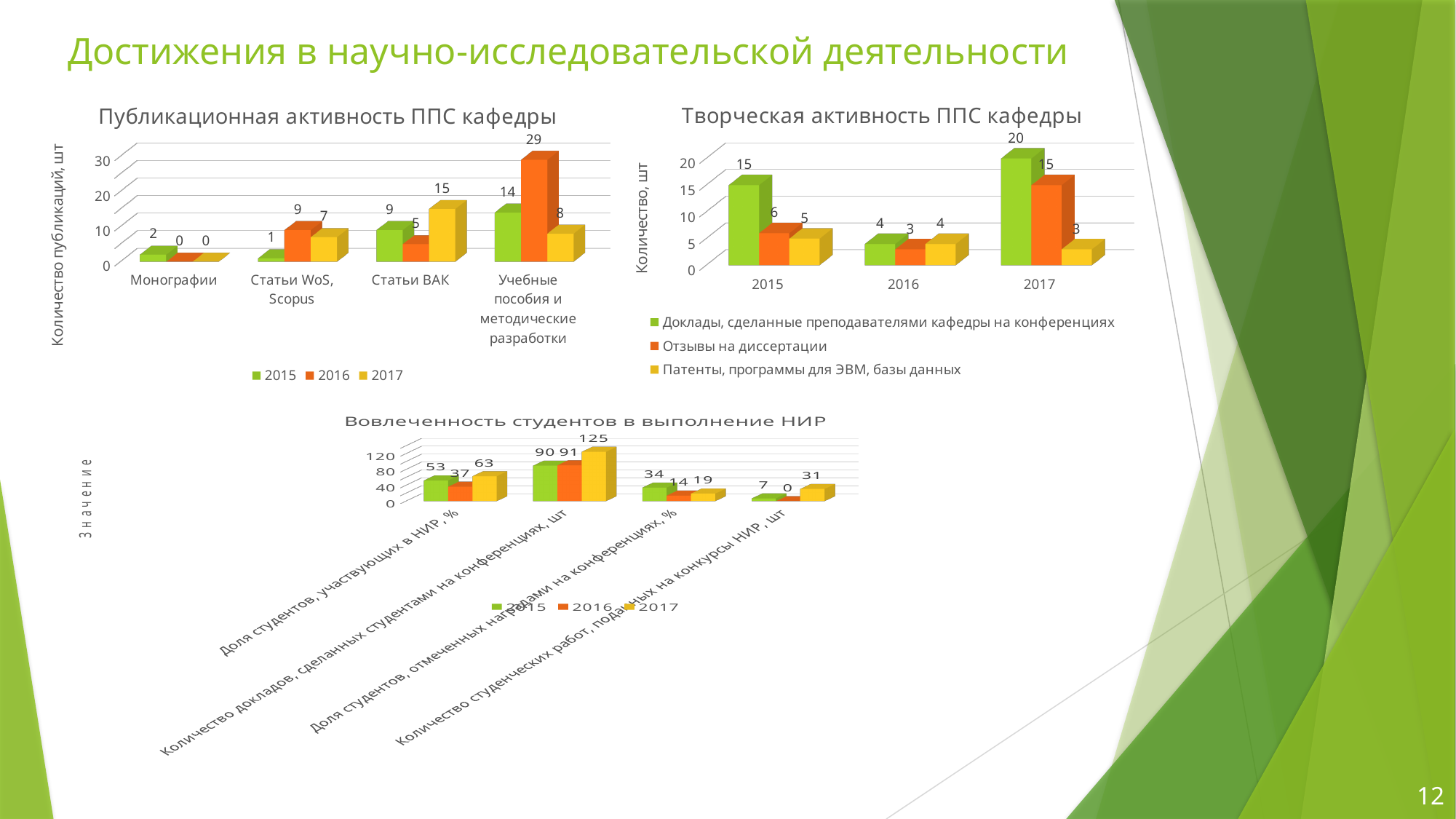
In the chart 'Творческая активность ППС кафедры', is the value for Патенты, программы для ЭВМ, базы данных larger in 2015 or in 2017? 2015 In the chart 'Публикационная активность ППС кафедры', which category has the highest value for 2016? Учебные пособия и методические разработки In the chart 'Творческая активность ППС кафедры', which year has the lowest value for Доклады, сделанные преподавателями кафедры на конференциях? 2016 In the chart 'Публикационная активность ППС кафедры', what is the value for Статьи ВАК in 2017? 15 In the chart 'Творческая активность ППС кафедры', how many series does the legend list? 3 In the chart 'Творческая активность ППС кафедры', what is the value for Отзывы на диссертации in 2017? 15 What kind of chart is 'Вовлеченность студентов в выполнение НИР'? Bar chart In the chart 'Публикационная активность ППС кафедры', what is the difference between the 2016 and 2017 values for Учебные пособия и методические разработки? 21 In the chart 'Публикационная активность ППС кафедры', how many categories are shown on the x axis? 4 In the chart 'Вовлеченность студентов в выполнение НИР', what is the difference between the 2017 and 2015 values for Доля студентов, участвующих в НИР, %? 10 In the chart 'Вовлеченность студентов в выполнение НИР', what is the 2017 value for Количество докладов, сделанных студентами на конференциях, шт? 125 In the chart 'Вовлеченность студентов в выполнение НИР', what is the 2016 value for Количество студенческих работ, поданных на конкурсы НИР, шт? 0